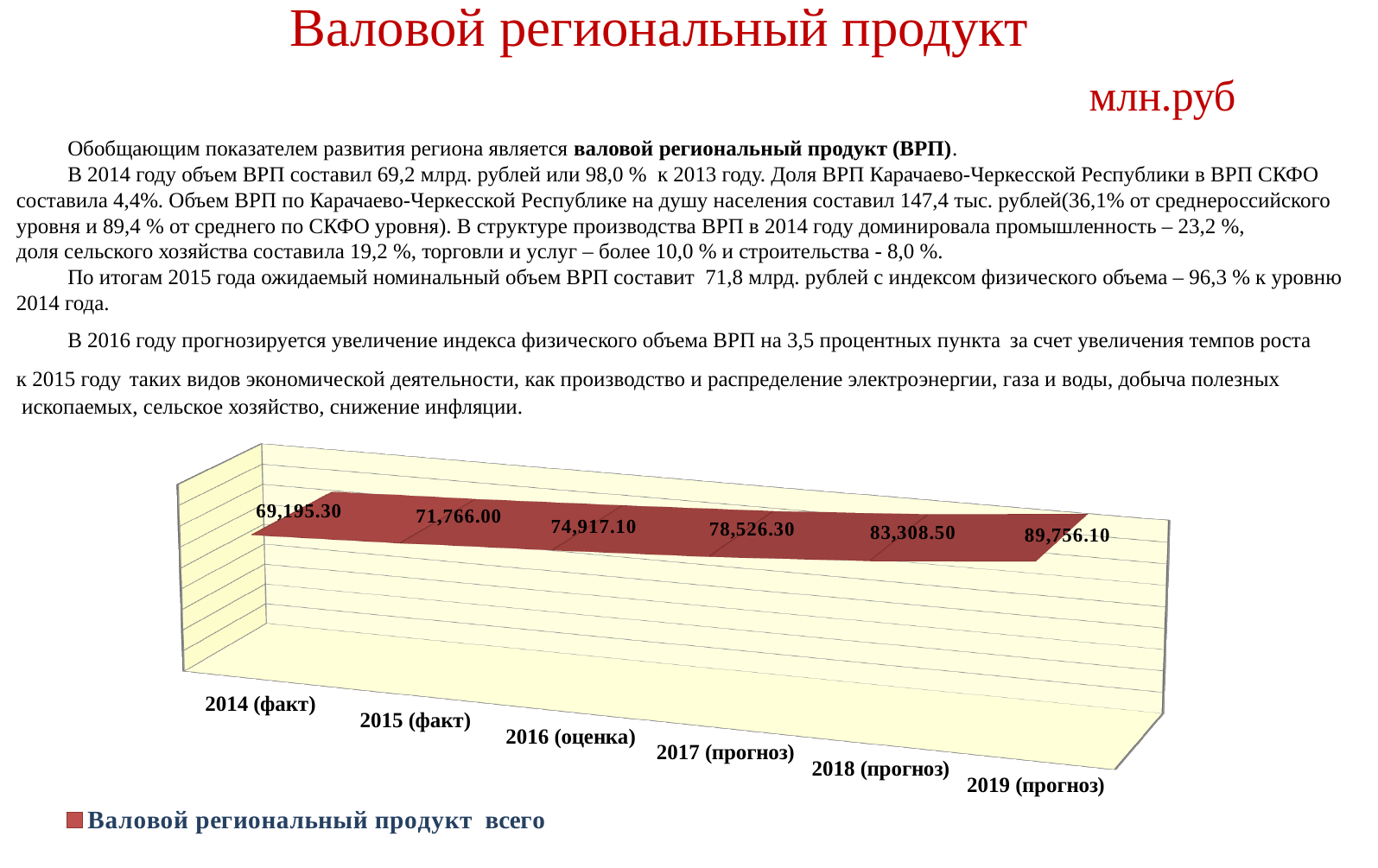
What is the difference between the values for 2018 (прогноз) and 2017 (прогноз)? 4,782.20 What is the value for 2014 (факт)? 69,195.30 What is the difference between the values for 2019 (прогноз) and 2014 (факт)? 20,560.80 How many series does the legend list? 1 Which category has the highest value? 2019 (прогноз) Which is larger, the value for 2016 (оценка) or the value for 2015 (факт)? 2016 (оценка) What is the value for 2019 (прогноз)? 89,756.10 Do the values rise or fall from 2014 (факт) to 2019 (прогноз)? rise What kind of chart is shown? line chart How many categories are shown on the x axis? 6 What is the value for 2017 (прогноз)? 78,526.30 Which category has the lowest value? 2014 (факт)